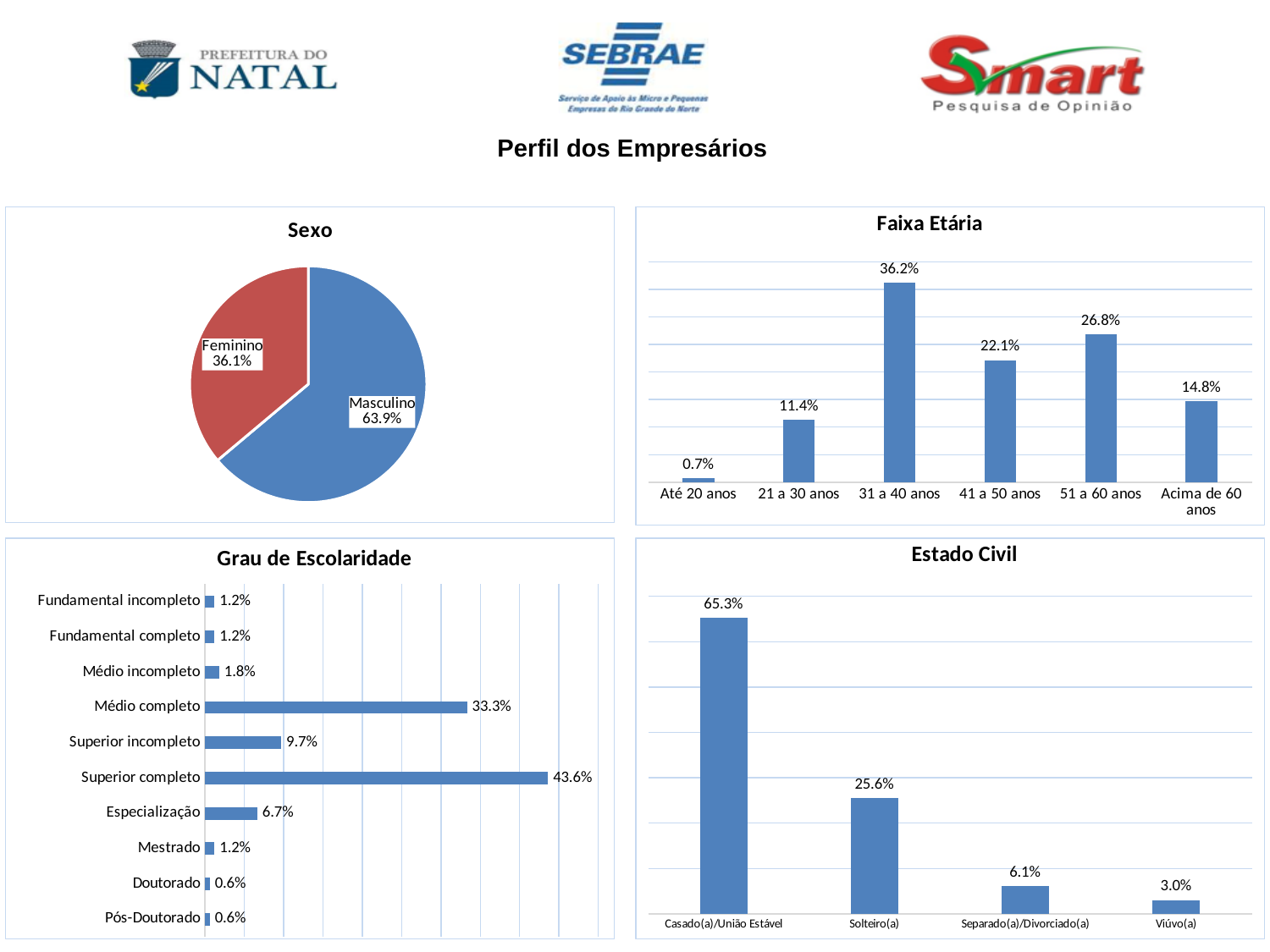
In the 'Faixa Etária' chart, which age group has the lowest value? Até 20 anos In the 'Faixa Etária' chart, what is the value for 31 a 40 anos? 36.2% In the 'Grau de Escolaridade' chart, how many categories are listed? 10 In the 'Estado Civil' chart, what is the difference between Casado(a)/União Estável and Solteiro(a)? 39.7% In the 'Faixa Etária' chart, how many age groups are shown? 6 In the 'Grau de Escolaridade' chart, which is larger, Médio completo or Superior incompleto? Médio completo In the 'Grau de Escolaridade' chart, what is the value for Especialização? 6.7% In the 'Grau de Escolaridade' chart, which category has the highest value? Superior completo In the 'Sexo' chart, what kind of chart is shown? pie chart In the 'Sexo' chart, what share of the pie is Masculino? 63.9% In the 'Faixa Etária' chart, what is the difference between 51 a 60 anos and 41 a 50 anos? 4.7% In the 'Estado Civil' chart, what is the value for Solteiro(a)? 25.6%